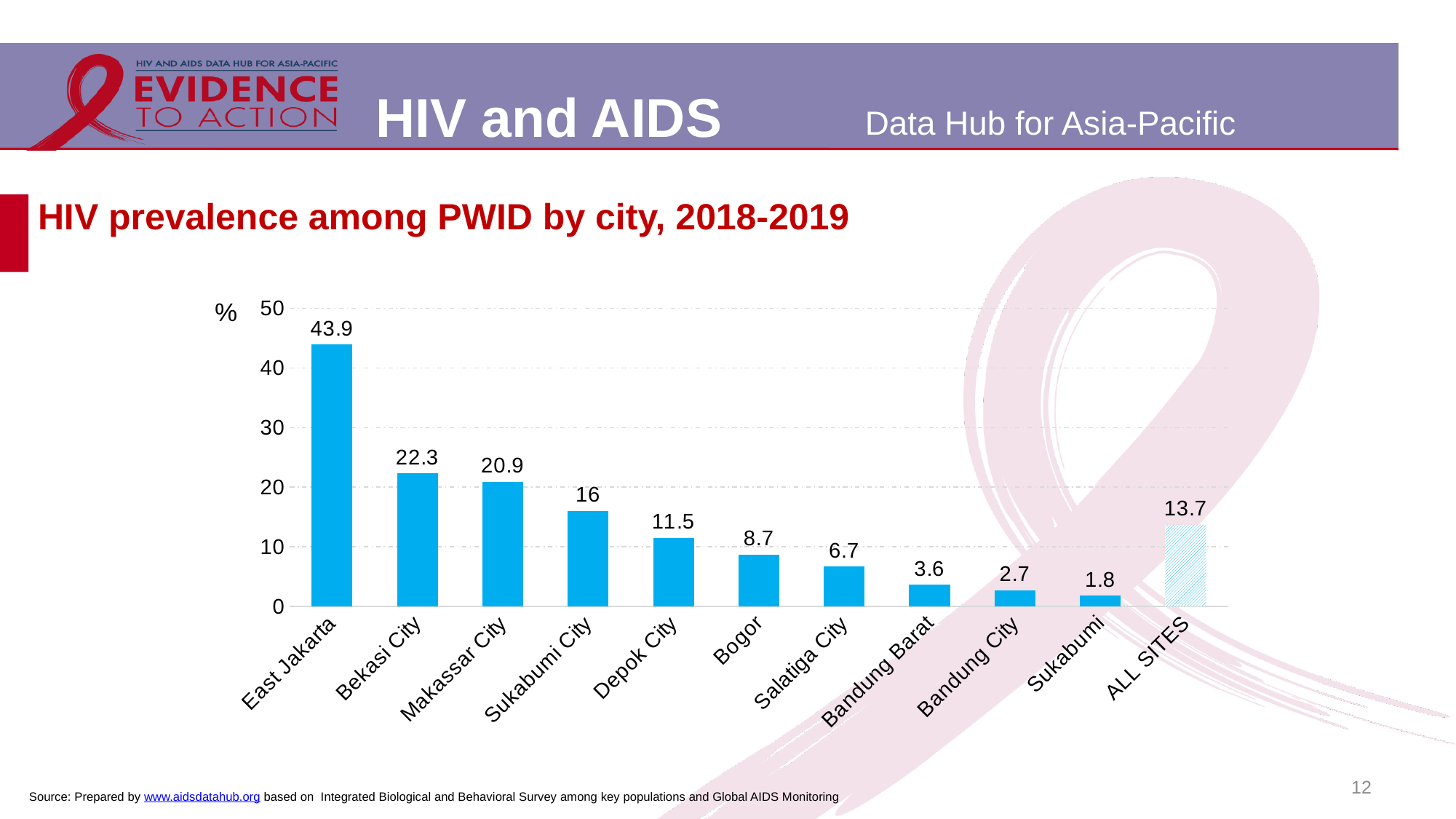
Which city has the highest HIV prevalence among PWID? East Jakarta What is the value shown for ALL SITES? 13.7 What kind of chart is shown on the slide? bar chart Do the city values rise or fall from left to right across the cities (excluding ALL SITES)? fall What is the HIV prevalence among PWID in East Jakarta? 43.9 Which city has the lowest HIV prevalence among PWID? Sukabumi What is the HIV prevalence among PWID in Depok City? 11.5 Is the value for Sukabumi City greater or less than 20? less What is the title of the chart? HIV prevalence among PWID by city, 2018-2019 Which has a higher HIV prevalence among PWID, Bogor or Salatiga City? Bogor What is the difference in HIV prevalence between Bekasi City and Makassar City? 1.4 How many categories are shown on the x axis of the chart? 11